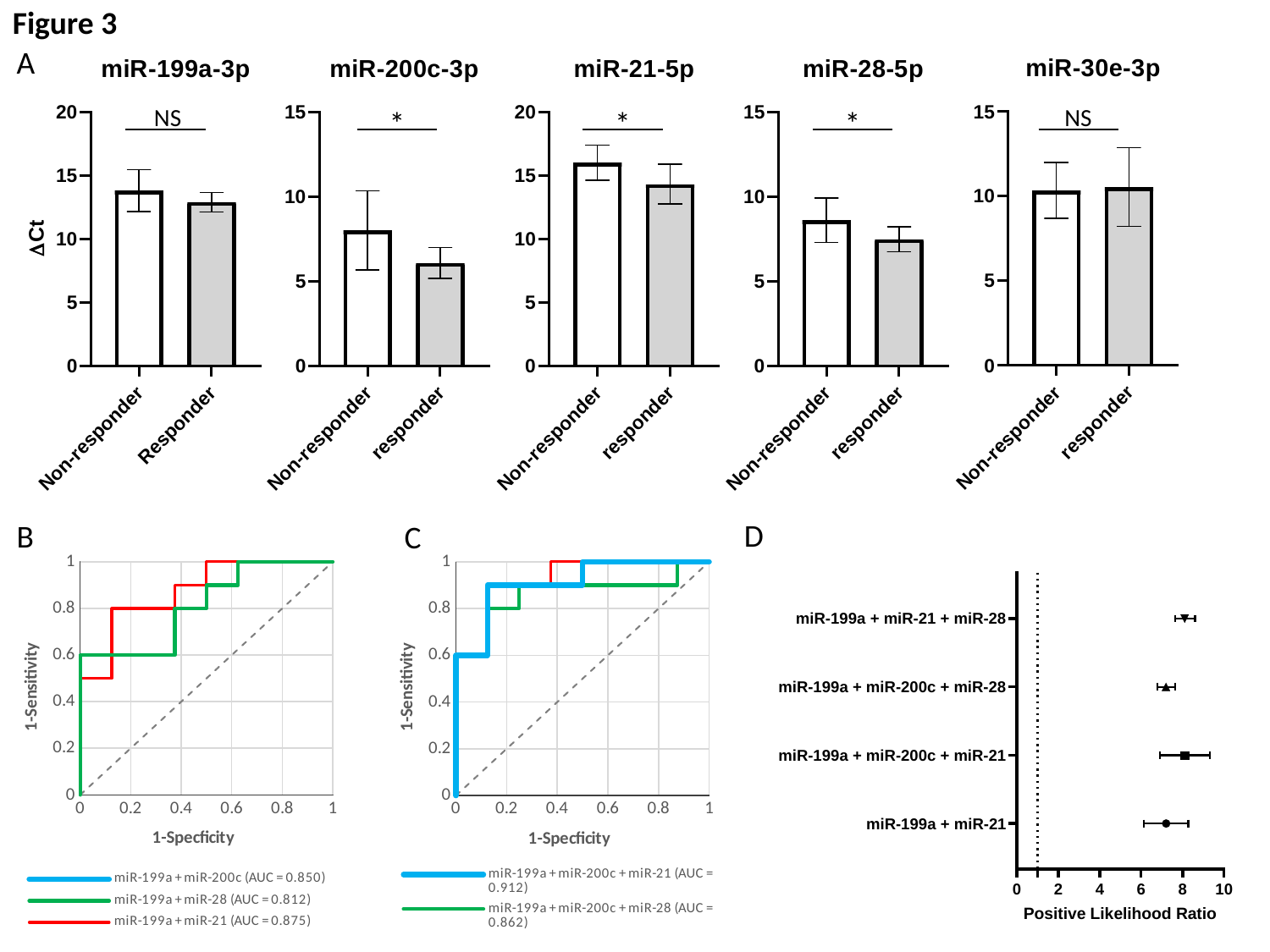
In panel D, is the Positive Likelihood Ratio for miR-199a + miR-21 greater or less than 6? greater In panel B, which miRNA combination has the highest AUC? miR-199a + miR-21 In the miR-200c-3p chart in panel A, which group has the higher ΔCt, Non-responder or responder? Non-responder In panel A, what kind of chart is used for each miRNA? bar chart In the miR-21-5p chart in panel A, which group has the higher ΔCt, Non-responder or responder? Non-responder How many miRNA combinations are plotted in panel D? 4 In panel B, what is the AUC for miR-199a + miR-21? 0.875 How many bar charts are shown in panel A? 5 How many series does the legend of panel B list? 3 In the miR-28-5p chart in panel A, is the ΔCt value for responder greater or less than 10? less In the miR-21-5p chart in panel A, is the ΔCt value for Non-responder greater or less than 10? greater In panel C, what is the difference between the AUC of miR-199a + miR-200c + miR-21 and the AUC of miR-199a + miR-200c + miR-28? 0.050